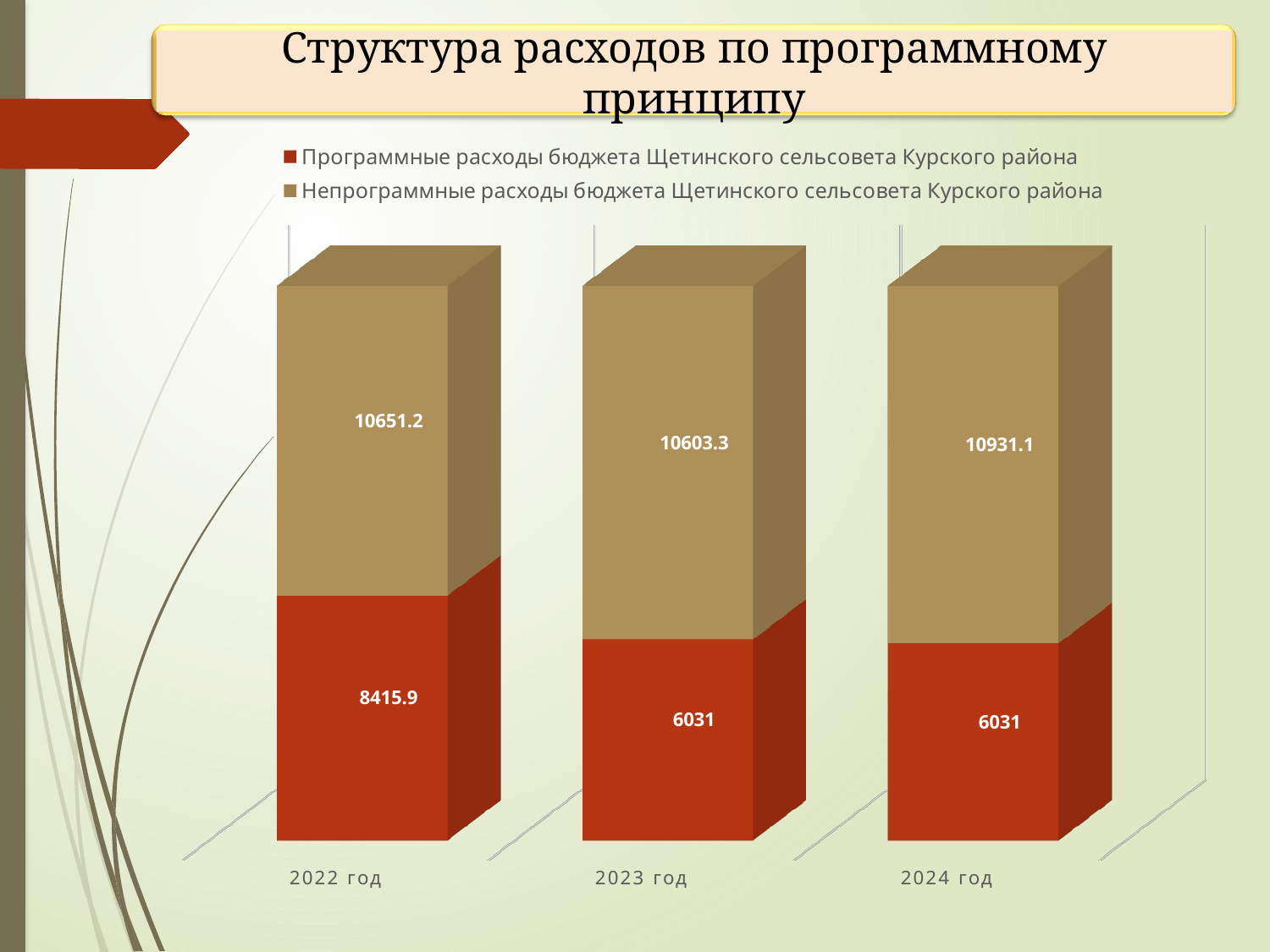
By how much does the value of Программные расходы for 2022 год exceed the value for 2023 год? 2384.9 What is the total of the two values shown for the 2023 год bar? 16634.3 What is the difference between Непрограммные расходы and Программные расходы for 2022 год? 2235.3 Which is larger for 2023 год: Программные расходы or Непрограммные расходы? Непрограммные расходы How many years are shown on the x axis of the chart? 3 What is the value of Непрограммные расходы бюджета Щетинского сельсовета Курского района for 2023 год? 10603.3 What is the value of Программные расходы бюджета Щетинского сельсовета Курского района for 2024 год? 6031 What is the value of Непрограммные расходы бюджета Щетинского сельсовета Курского района for 2024 год? 10931.1 In which year is the value of Программные расходы бюджета Щетинского сельсовета Курского района the highest? 2022 год In which year is the value of Непрограммные расходы бюджета Щетинского сельсовета Курского района the highest? 2024 год What type of chart is shown on the slide? Stacked bar chart What is the value of Программные расходы бюджета Щетинского сельсовета Курского района for 2022 год? 8415.9